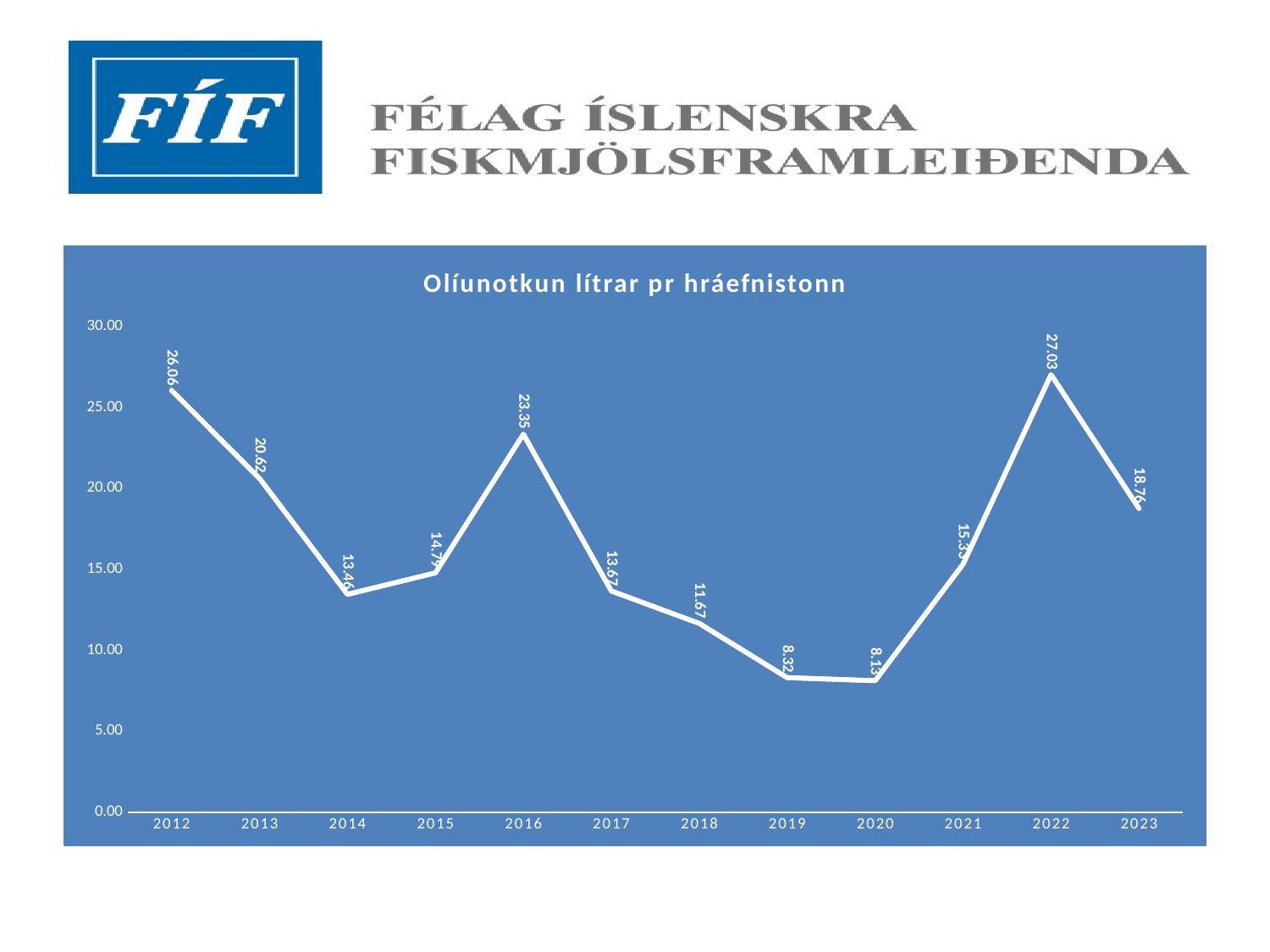
What is the value for 2016? 23.35 What is the difference between the values for 2012 and 2013? 5.44 What kind of chart is shown? line chart What is the value for 2012? 26.06 Which year has the highest value? 2022 What is the difference between the values for 2016 and 2017? 9.68 Do the values rise or fall from 2019 to 2022? rise Is the value for 2019 greater or less than 10.00? less How many years are plotted on the x axis? 12 Which is larger, the value for 2014 or the value for 2015? 2015 Which year has the lowest value? 2020 What is the value for 2023? 18.76